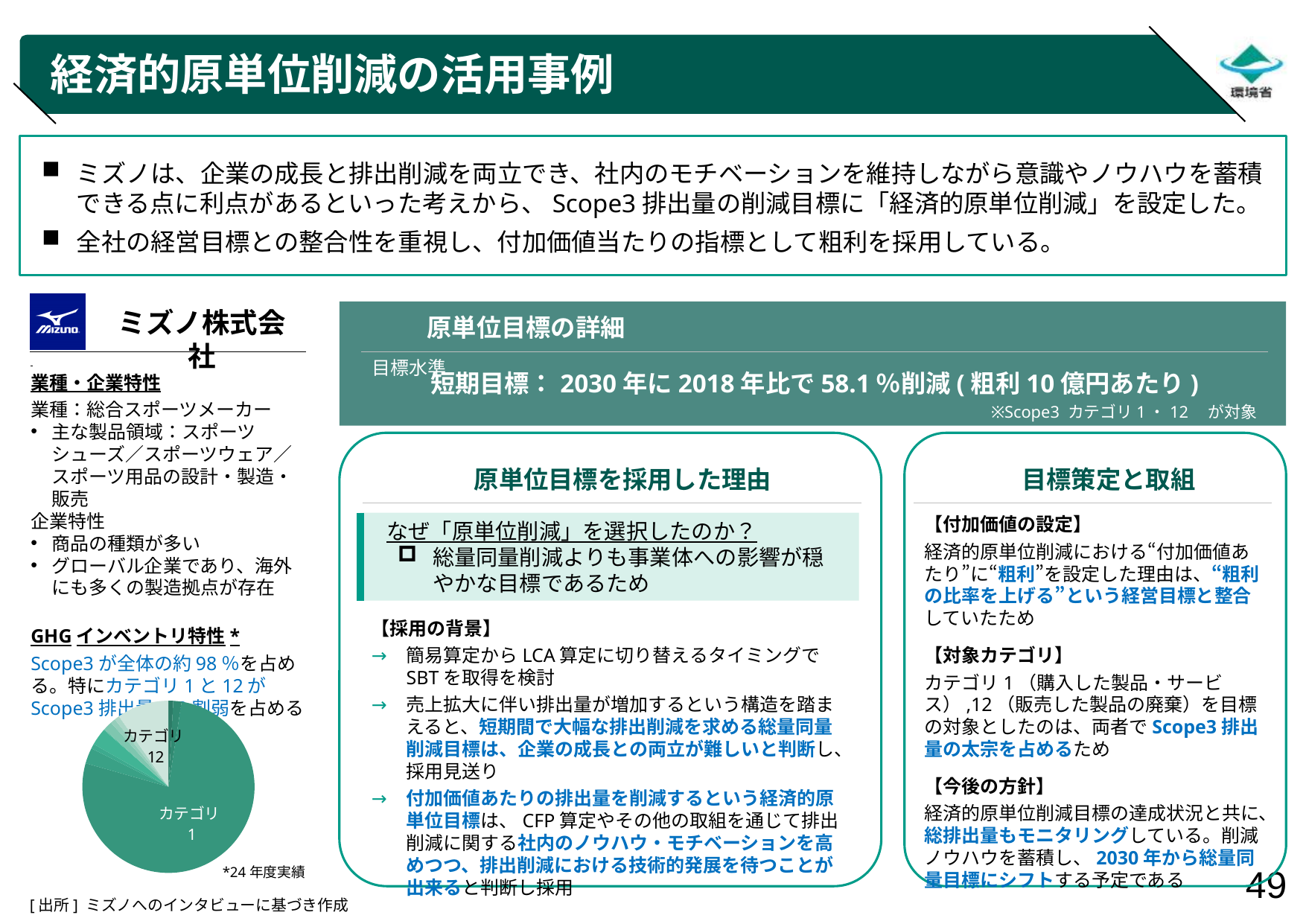
What are the two category labels shown on the pie chart at the bottom left? カテゴリ1 and カテゴリ12 In the pie chart at the bottom left, which slice is larger, カテゴリ1 or カテゴリ12? カテゴリ1 What kind of chart is shown at the bottom left of the slide under 'GHG インベントリ特性'? pie chart What footnote is printed next to the pie chart at the bottom left indicating the data period? *24年度実績 In the pie chart at the bottom left, which of the two labeled categories has the smaller slice? カテゴリ12 In the pie chart at the bottom left, which labeled category has the largest slice? カテゴリ1 How many slices in the pie chart at the bottom left carry a readable category label? 2